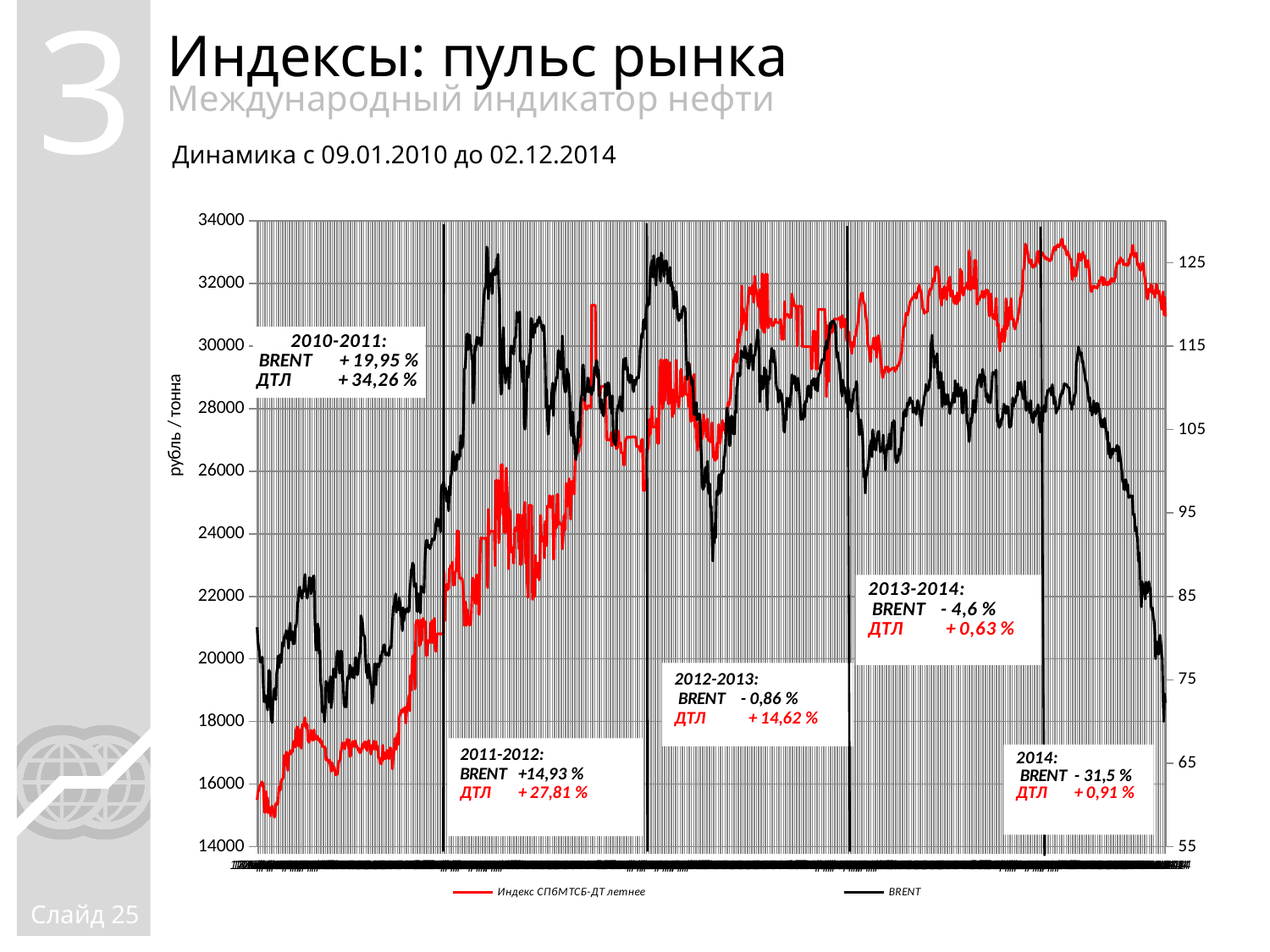
Is the value of the red Индекс СПбМТСБ-ДТ летнее line at the end of the period greater or less than 30000 on the left axis? greater According to the annotation for 2014, what is the change for BRENT? - 31,5 % How many series does the legend list? 2 What is the label of the left vertical axis? рубль / тонна Which series is drawn in red according to the legend? Индекс СПбМТСБ-ДТ летнее Is the value of the black BRENT line at the end of the period greater or less than 75 on the right axis? less What kind of chart is shown on the slide? line chart Does the black BRENT line rise or fall over the final 2014 segment of the chart? fall According to the annotation for 2010-2011, what is the change for BRENT? + 19,95 % According to the annotation for 2013-2014, what is the change for BRENT? - 4,6 % According to the annotation for 2011-2012, what is the change for ДТЛ? + 27,81 % According to the annotation for 2012-2013, what is the change for ДТЛ? + 14,62 %